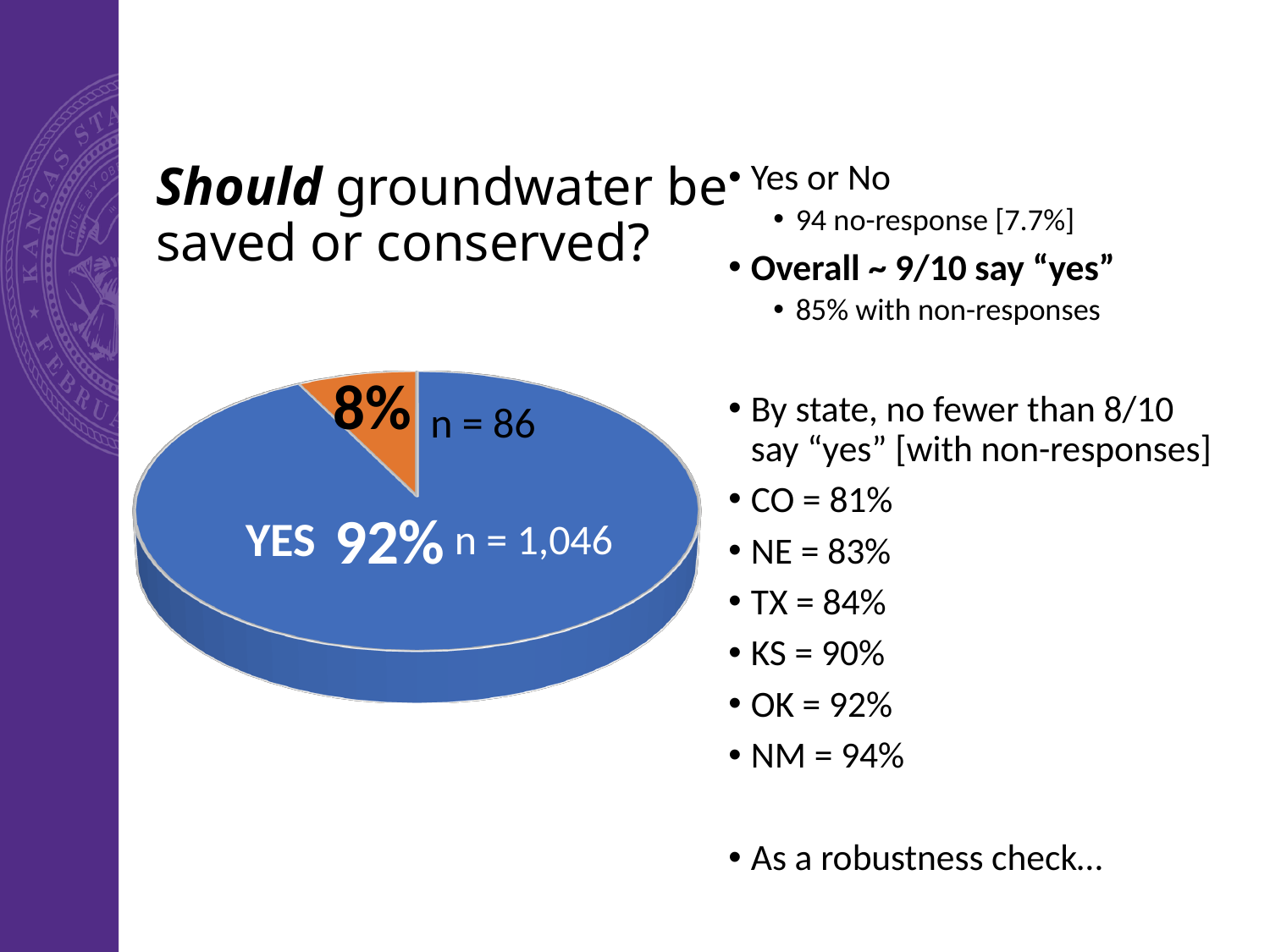
What is the n value shown for the YES slice? n = 1,046 What is the n value shown for the orange slice? n = 86 Is the YES slice larger or smaller than the orange slice? Larger How many slices does the pie chart have? 2 What percentage of the pie chart is the YES slice? 92% What kind of chart is shown on the slide? Pie chart What is the difference between the n values of the two slices? 960 What is the difference in percentage points between the YES slice and the orange slice? 84 percentage points Which slice of the pie chart is the smallest? The orange slice (8%) What colour is the YES slice of the pie chart? Blue What percentage of the pie chart is the orange slice? 8% Which slice of the pie chart is the largest? YES